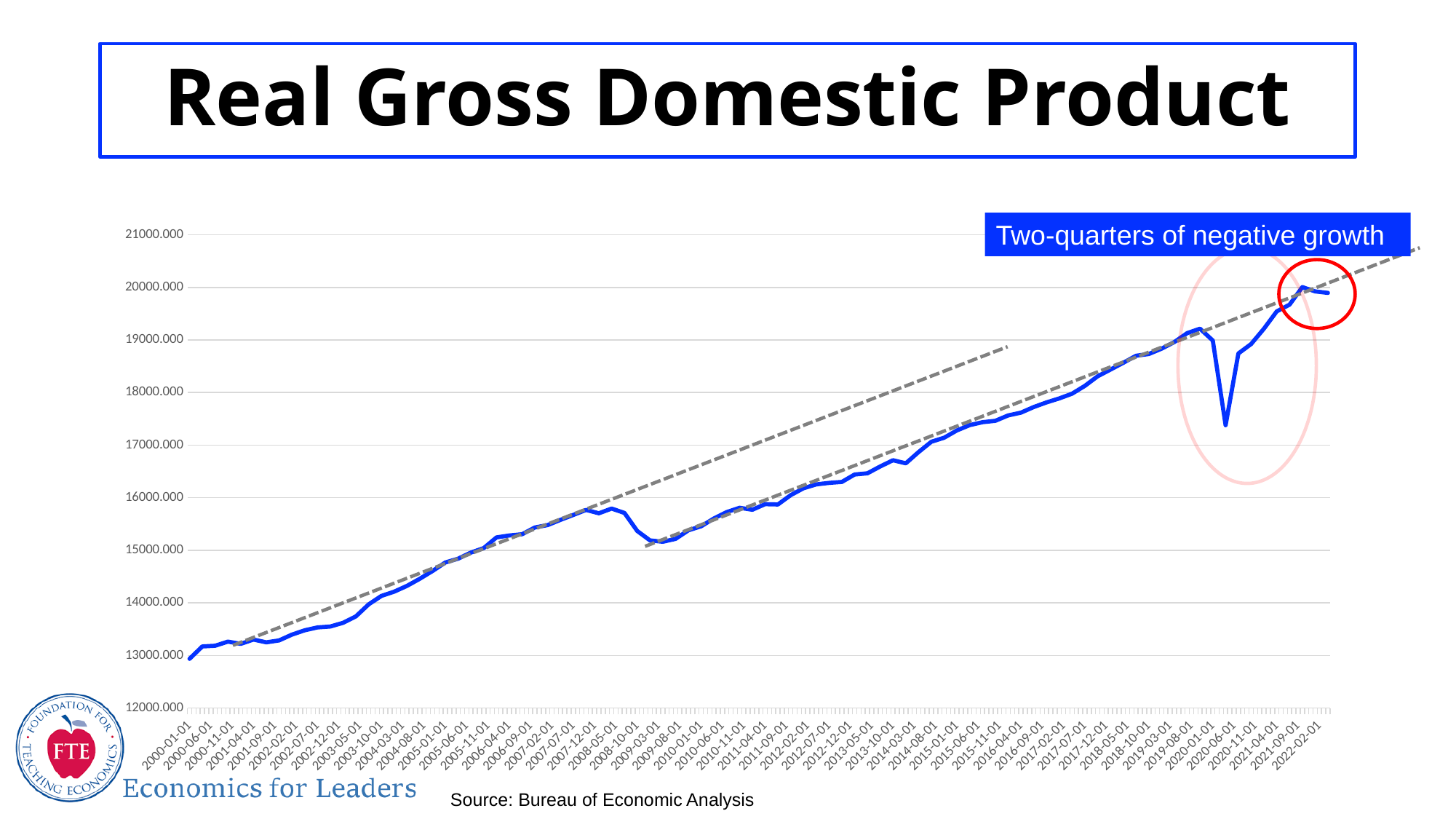
Is the value for 2000-01-01 greater or less than 14000? less Is the value for 2022-02-01 greater or less than 19000? greater Is the value for 2016-04-01 greater or less than 17000? greater Overall, do the plotted values rise or fall from 2000 to 2022? rise Which date on the x axis has the lowest plotted value? 2000-01-01 What does the annotation box in the upper right of the chart say? Two-quarters of negative growth What is the title of the slide's chart? Real Gross Domestic Product What kind of chart is shown on the slide? line chart Is the value for 2022-02-01 larger or smaller than the value for 2020-06-01? larger